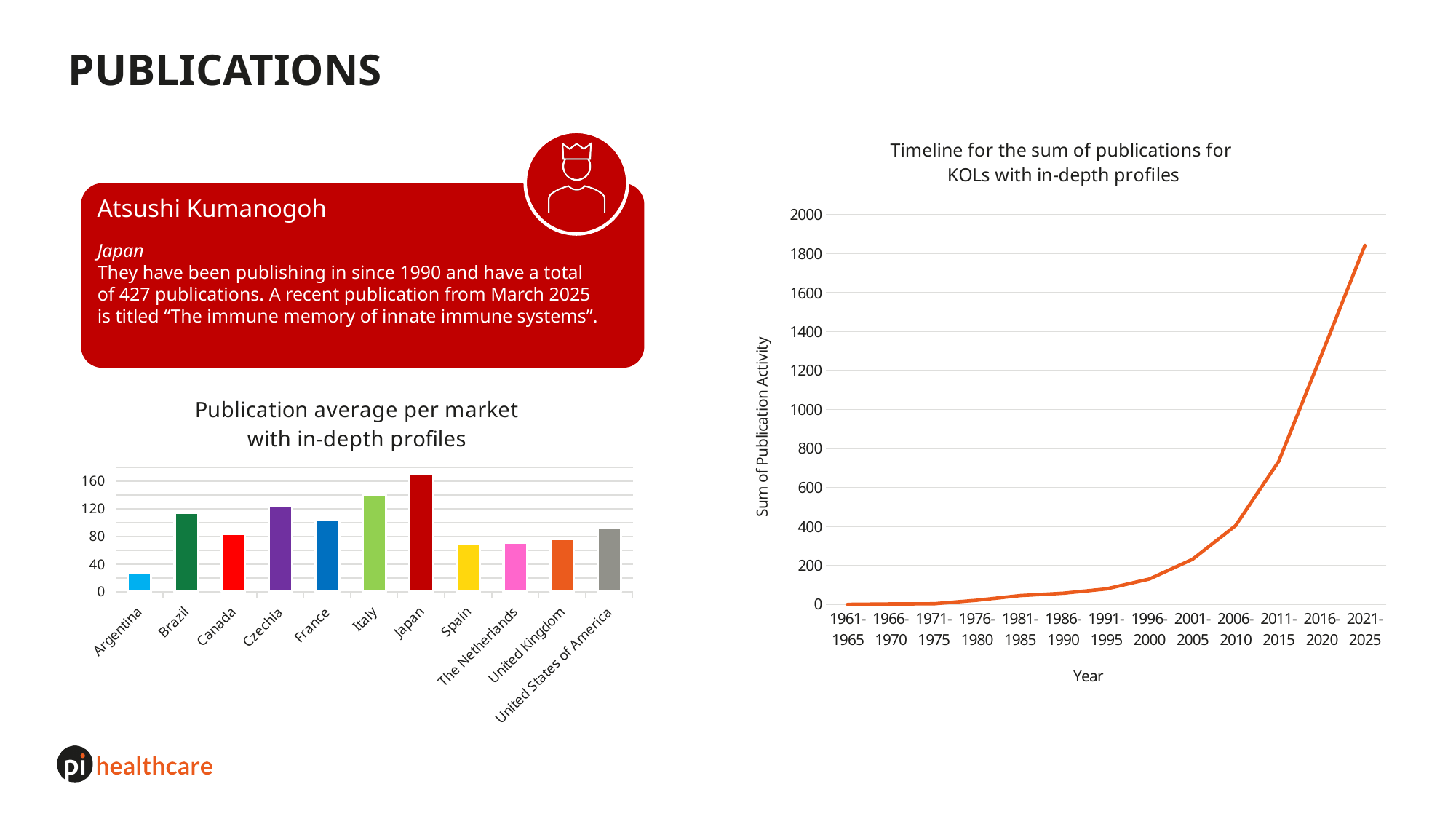
In the 'Publication average per market with in-depth profiles' chart, how many markets are shown? 11 In the 'Publication average per market with in-depth profiles' chart, is the value for Japan greater or less than 160? greater In the 'Timeline for the sum of publications for KOLs with in-depth profiles' chart, is the value for 2011-2015 greater or less than 600? greater What is the y-axis title of the 'Timeline for the sum of publications for KOLs with in-depth profiles' chart? Sum of Publication Activity In the 'Publication average per market with in-depth profiles' chart, which market has the highest value? Japan In the 'Timeline for the sum of publications for KOLs with in-depth profiles' chart, do the values rise or fall over the years? rise In the 'Publication average per market with in-depth profiles' chart, is the value for Argentina greater or less than 40? less What kind of chart is the 'Timeline for the sum of publications for KOLs with in-depth profiles' chart? line chart In the 'Publication average per market with in-depth profiles' chart, which is larger, Italy or Brazil? Italy In the 'Publication average per market with in-depth profiles' chart, which market has the lowest value? Argentina What kind of chart is the 'Publication average per market with in-depth profiles' chart? bar chart